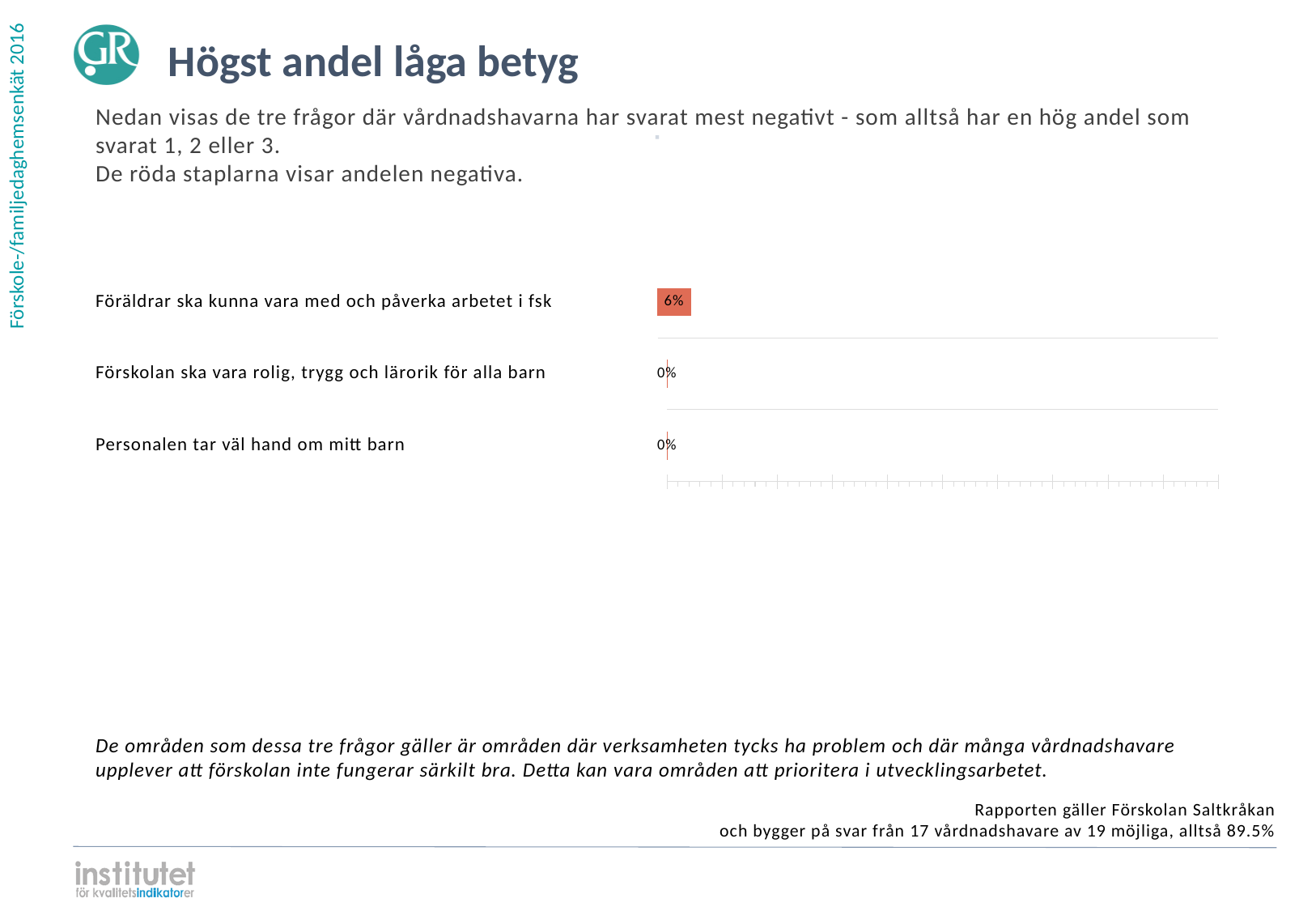
What is the title of the slide containing the chart? Högst andel låga betyg Which is larger: the value for "Föräldrar ska kunna vara med och påverka arbetet i fsk" or the value for "Förskolan ska vara rolig, trygg och lärorik för alla barn"? Föräldrar ska kunna vara med och påverka arbetet i fsk Which category has the highest share of negative answers? Föräldrar ska kunna vara med och påverka arbetet i fsk What colour are the bars in the chart? Red What kind of chart is shown on the slide? Bar chart What is the value shown for "Personalen tar väl hand om mitt barn"? 0% What is the difference between the value for "Föräldrar ska kunna vara med och påverka arbetet i fsk" and the value for "Personalen tar väl hand om mitt barn"? 6% What is the value shown for "Förskolan ska vara rolig, trygg och lärorik för alla barn"? 0% How many categories are shown in the chart? 3 How many categories in the chart have a value of 0%? 2 What is the value shown for "Föräldrar ska kunna vara med och påverka arbetet i fsk"? 6%